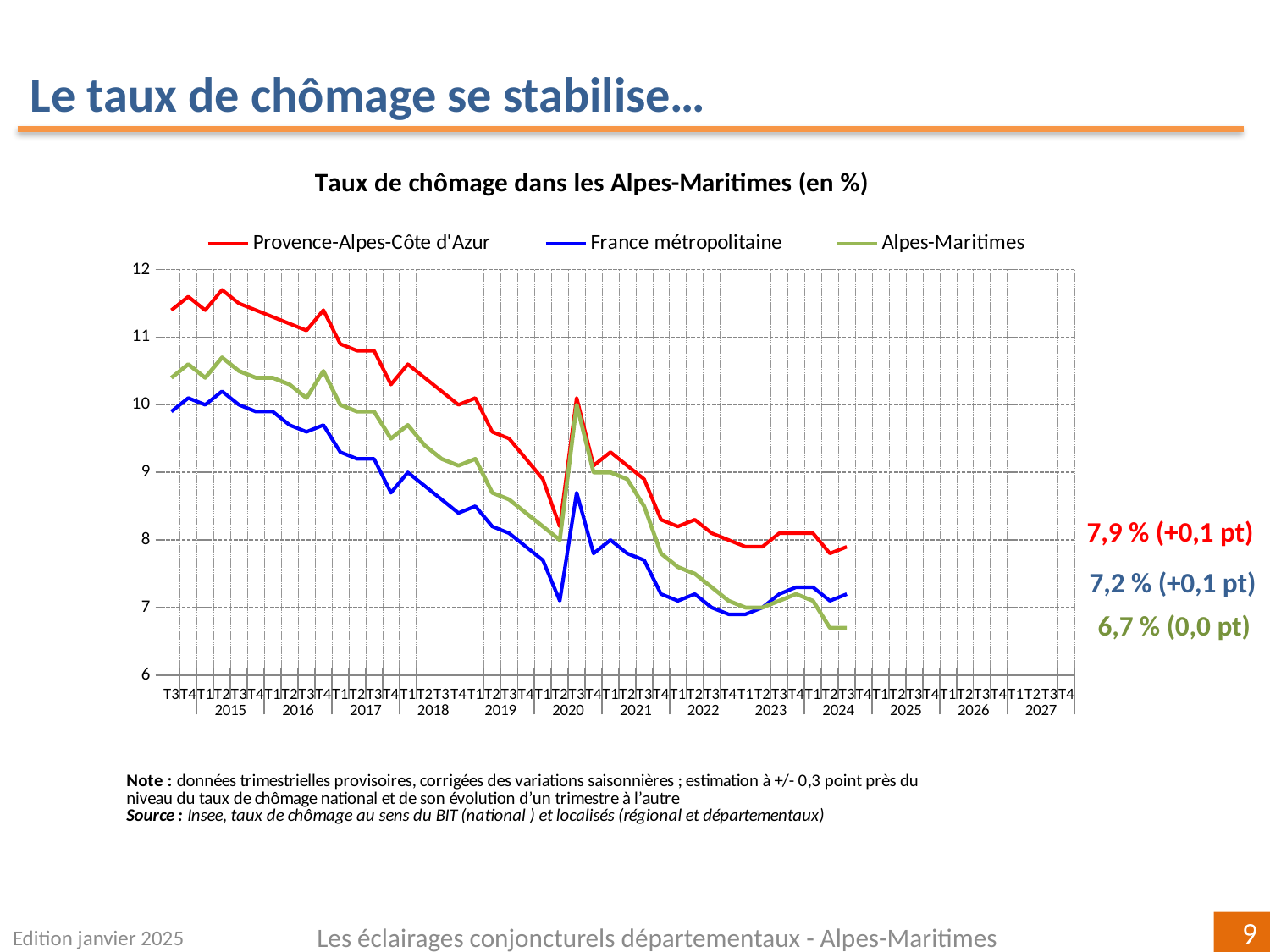
What quarterly change is indicated next to the latest Alpes-Maritimes value? 0,0 pt What is the difference between the latest values for Provence-Alpes-Côte d'Azur and Alpes-Maritimes? 1,2 points Which series has the highest latest value? Provence-Alpes-Côte d'Azur Is the latest value for France métropolitaine larger or smaller than the latest value for Alpes-Maritimes? larger What is the latest unemployment rate shown for France métropolitaine? 7,2 % What kind of chart is shown on the slide? line chart What is the latest unemployment rate shown for Alpes-Maritimes? 6,7 % Which series has the lowest latest value? Alpes-Maritimes What is the latest unemployment rate shown for Provence-Alpes-Côte d'Azur? 7,9 % Is the value for Provence-Alpes-Côte d'Azur at T2 2015 greater or less than 11? greater Overall, do the unemployment rates rise or fall between 2015 and 2024? fall How many series does the legend list? 3